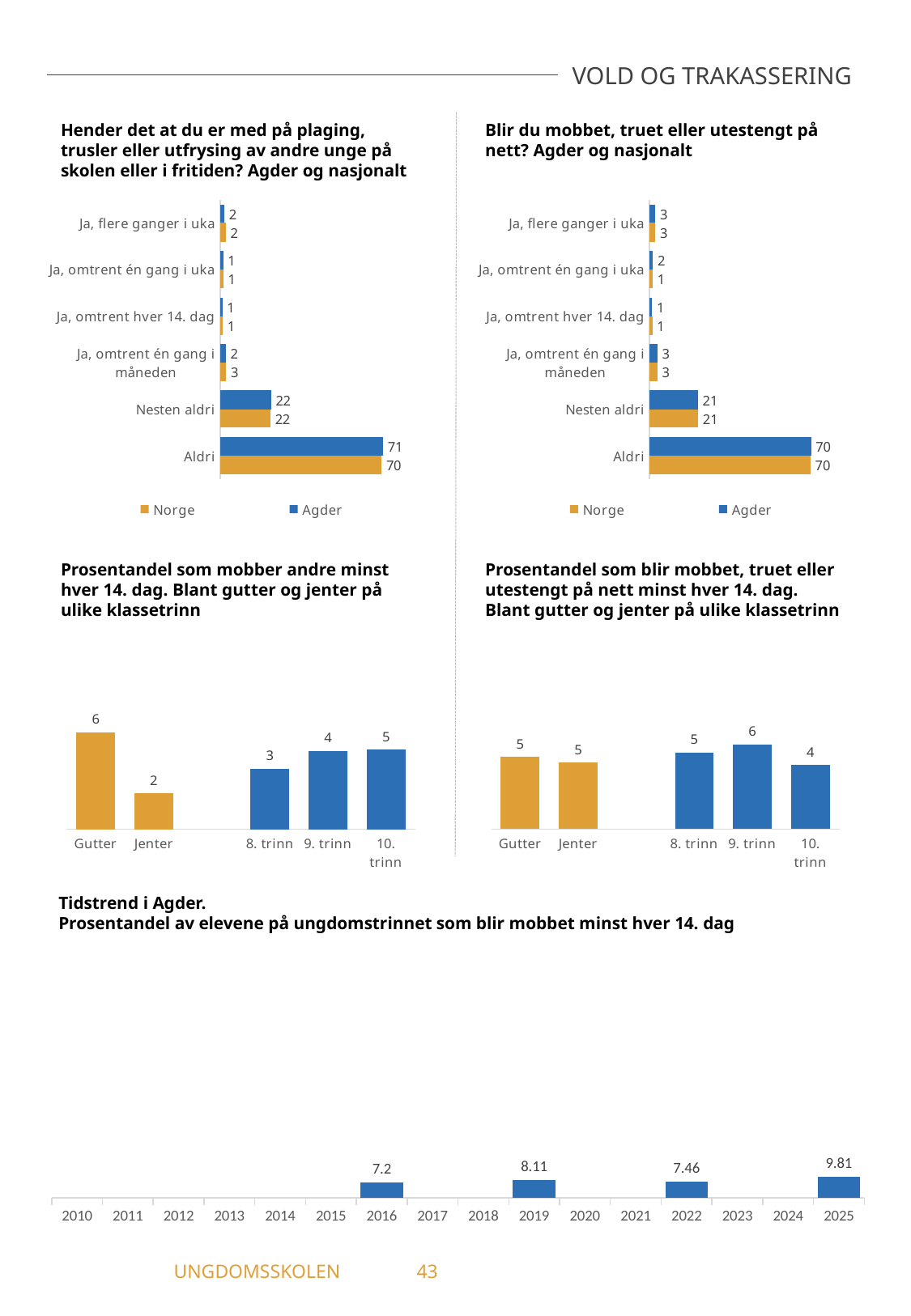
In the chart 'Prosentandel som mobber andre minst hver 14. dag. Blant gutter og jenter på ulike klassetrinn', what is the value for Jenter? 2 In the chart 'Hender det at du er med på plaging, trusler eller utfrysing av andre unge på skolen eller i fritiden? Agder og nasjonalt', what is the Agder value for 'Aldri'? 71 In the chart 'Tidstrend i Agder', which year has the lowest value? 2016 In the chart 'Prosentandel som mobber andre minst hver 14. dag. Blant gutter og jenter på ulike klassetrinn', which category has the highest value? Gutter In the chart 'Hender det at du er med på plaging, trusler eller utfrysing av andre unge på skolen eller i fritiden? Agder og nasjonalt', how many series does the legend list? 2 In the chart 'Prosentandel som blir mobbet, truet eller utestengt på nett minst hver 14. dag. Blant gutter og jenter på ulike klassetrinn', which class level has the lowest value? 10. trinn In the chart 'Tidstrend i Agder', what is the value for 2025? 9.81 In the chart 'Blir du mobbet, truet eller utestengt på nett? Agder og nasjonalt', what is the Agder value for 'Ja, omtrent én gang i uka'? 2 In the chart 'Blir du mobbet, truet eller utestengt på nett? Agder og nasjonalt', how many response categories are shown? 6 In the chart 'Blir du mobbet, truet eller utestengt på nett? Agder og nasjonalt', what is the difference between the Agder values for 'Aldri' and 'Nesten aldri'? 49 In the chart 'Hender det at du er med på plaging, trusler eller utfrysing av andre unge på skolen eller i fritiden? Agder og nasjonalt', what is the Norge value for 'Ja, omtrent én gang i måneden'? 3 In the chart 'Prosentandel som blir mobbet, truet eller utestengt på nett minst hver 14. dag. Blant gutter og jenter på ulike klassetrinn', what is the value for 9. trinn? 6